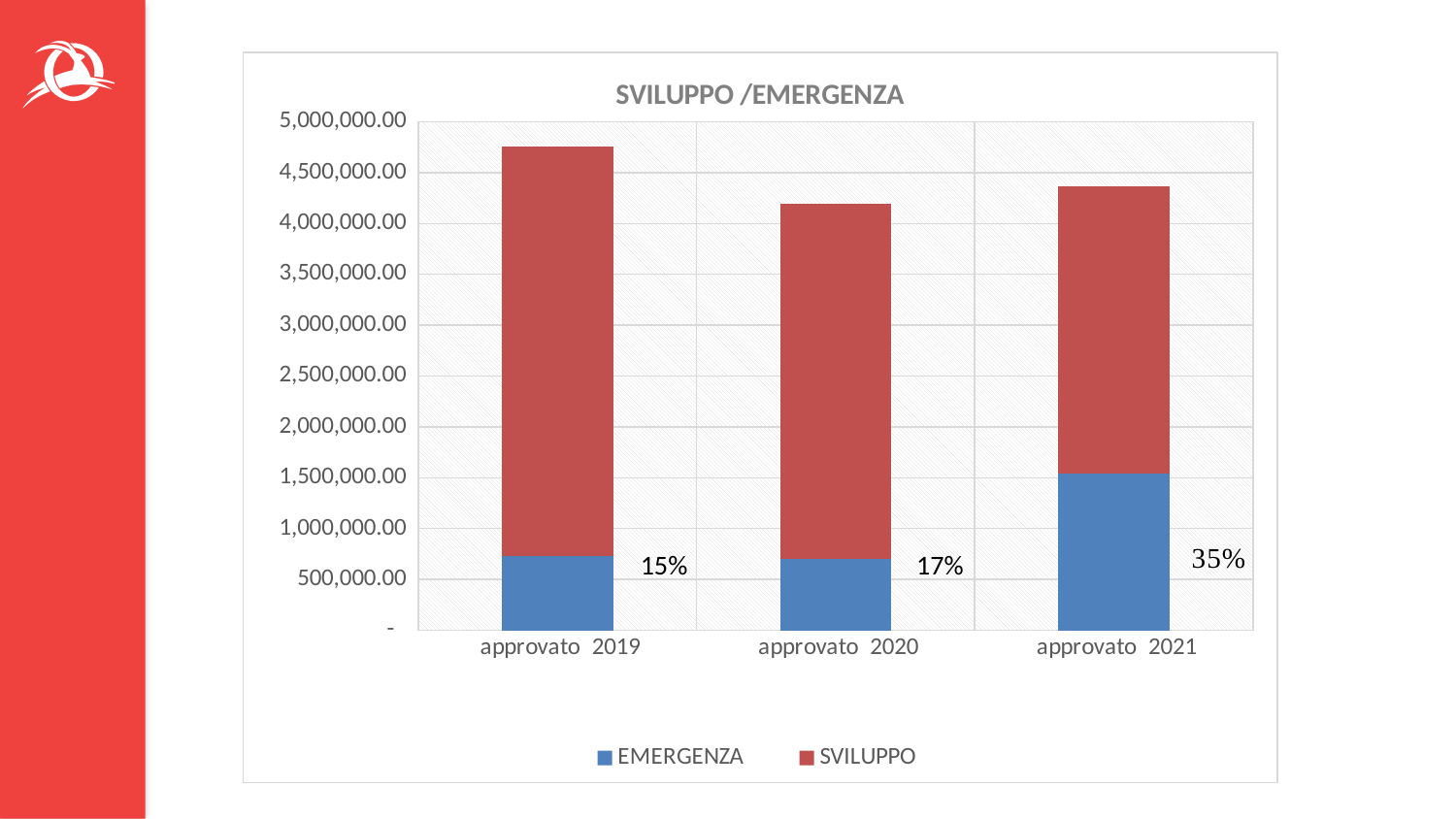
Which category has the largest EMERGENZA value? approvato 2021 Is the total stacked bar for approvato 2019 greater or less than 4,500,000.00? greater Is the EMERGENZA value for approvato 2019 greater or less than 1,000,000.00? less How many categories are shown on the x axis? 3 Which series is shown in blue? EMERGENZA Which category has the tallest total stacked bar? approvato 2019 Do the percentage labels rise or fall from approvato 2019 to approvato 2021? rise How many series does the legend list? 2 What percentage label is shown next to the bar for approvato 2019? 15% What percentage label is shown next to the bar for approvato 2021? 35% What kind of chart is shown on the slide? stacked bar chart What is the title of the chart? SVILUPPO /EMERGENZA